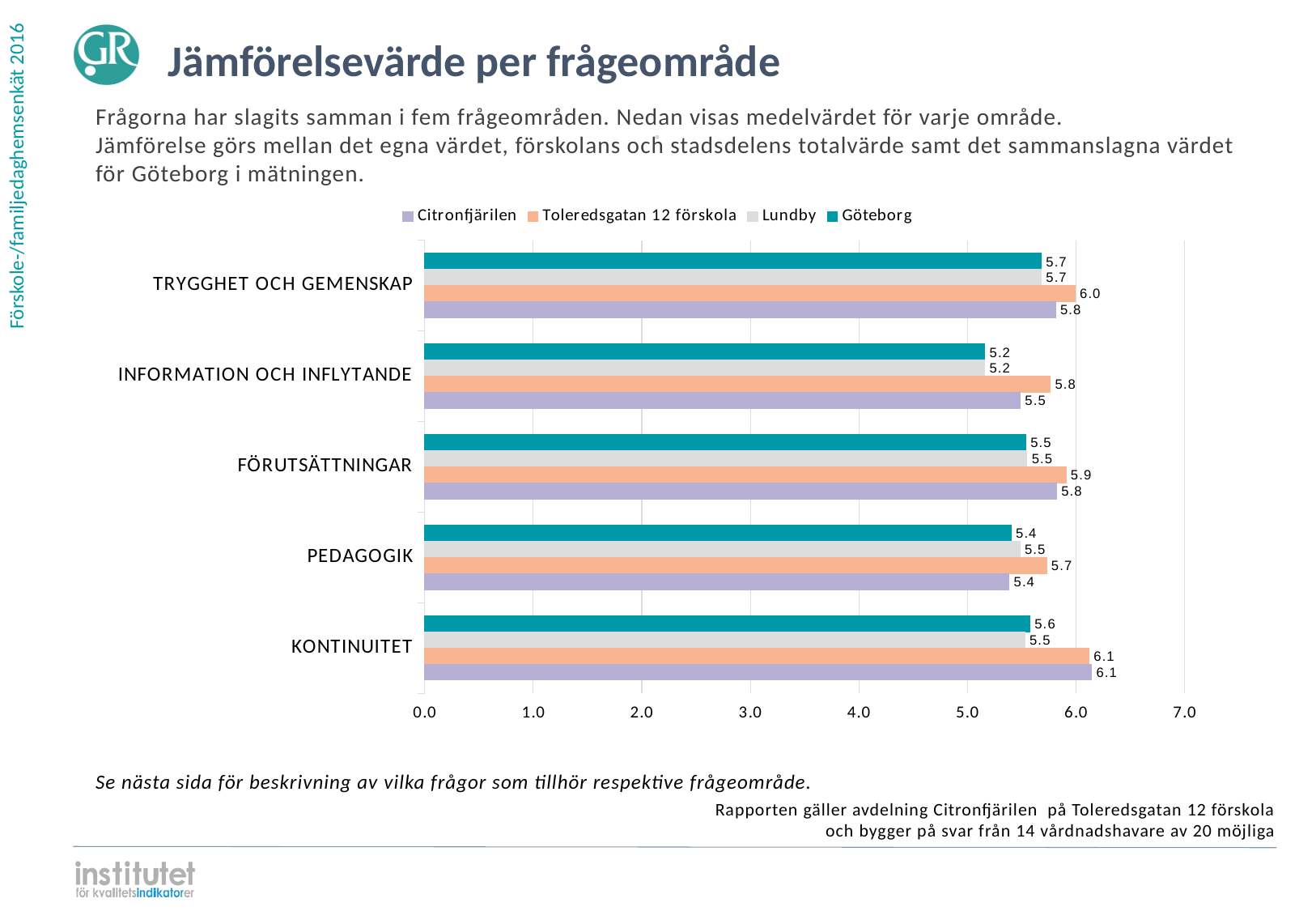
What is the value for Lundby in the PEDAGOGIK category? 5.5 How many series does the legend list? 4 What kind of chart is shown on the slide? Bar chart How many question areas (categories) are shown on the chart? 5 In which category does Citronfjärilen have its lowest value? PEDAGOGIK Which series is shown in teal on the chart? Göteborg What is the value for Göteborg in the INFORMATION OCH INFLYTANDE category? 5.2 What is the value for Toleredsgatan 12 förskola in the TRYGGHET OCH GEMENSKAP category? 6.0 What is the difference between the Toleredsgatan 12 förskola value and the Göteborg value in the INFORMATION OCH INFLYTANDE category? 0.6 In which category does Toleredsgatan 12 förskola have its highest value? KONTINUITET In the FÖRUTSÄTTNINGAR category, which is larger: the value for Citronfjärilen or the value for Lundby? Citronfjärilen What is the value for Citronfjärilen in the KONTINUITET category? 6.1